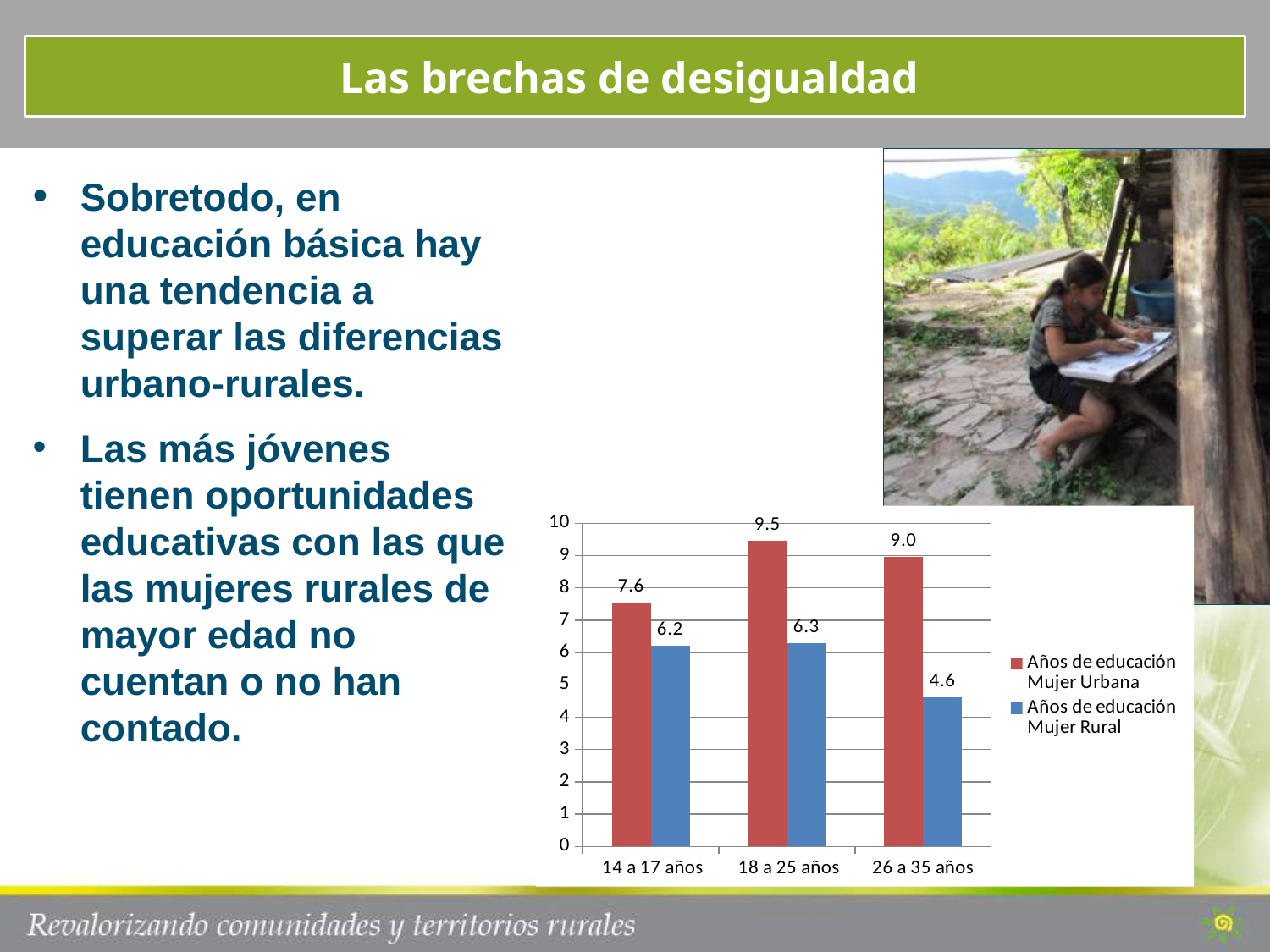
Do the values for Años de educación Mujer Rural rise or fall from 18 a 25 años to 26 a 35 años? Fall How many series does the chart legend list? 2 What is the value for Años de educación Mujer Rural in the 26 a 35 años category? 4.6 How many age categories are shown on the x axis of the chart? 3 Which is larger in the 14 a 17 años category: Años de educación Mujer Urbana or Años de educación Mujer Rural? Años de educación Mujer Urbana What kind of chart is shown on the slide? Bar chart What is the value for Años de educación Mujer Urbana in the 14 a 17 años category? 7.6 Which age category has the lowest value for Años de educación Mujer Rural? 26 a 35 años What is the value for Años de educación Mujer Rural in the 18 a 25 años category? 6.3 Is the value for Años de educación Mujer Urbana in the 26 a 35 años category greater or less than 8? greater Which age category has the highest value for Años de educación Mujer Urbana? 18 a 25 años What is the difference between Años de educación Mujer Urbana and Años de educación Mujer Rural in the 26 a 35 años category? 4.4